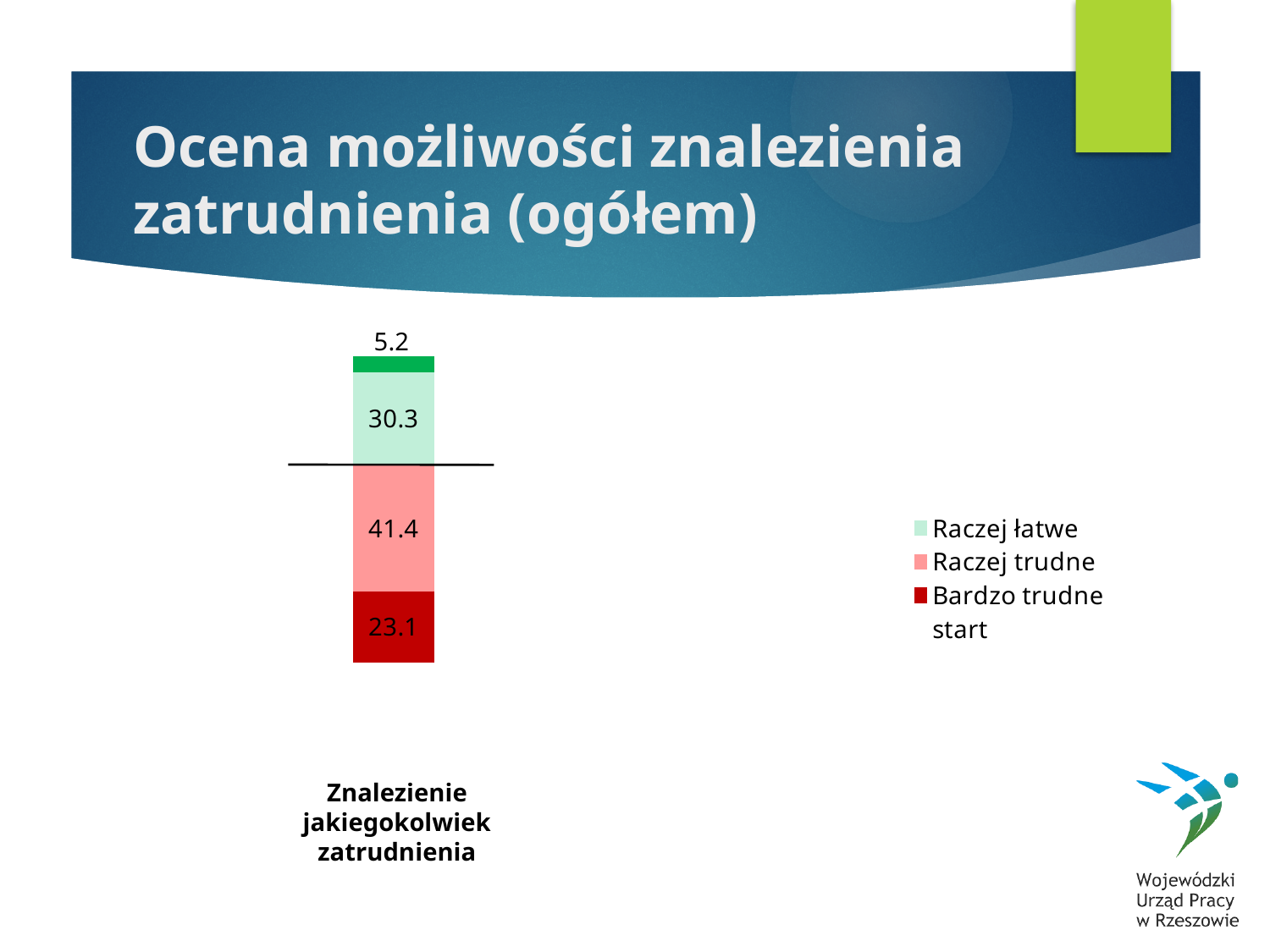
Which legend series has the largest segment in the bar? Raczej trudne What is the value of the Bardzo trudne segment in the stacked bar? 23.1 What is the value of the Raczej trudne segment in the stacked bar? 41.4 What is the total of all the values printed on the stacked bar? 100 What kind of chart is shown on the slide? Stacked bar chart What value is printed above the top of the stacked bar? 5.2 What is the category label printed under the bar? Znalezienie jakiegokolwiek zatrudnienia What is the difference between the Raczej trudne and Bardzo trudne values? 18.3 What is the difference between the Raczej trudne and Raczej łatwe values? 11.1 Which is larger, the Raczej łatwe value or the Bardzo trudne value? Raczej łatwe What is the value of the Raczej łatwe segment in the stacked bar? 30.3 What is the smallest value printed on the bar? 5.2